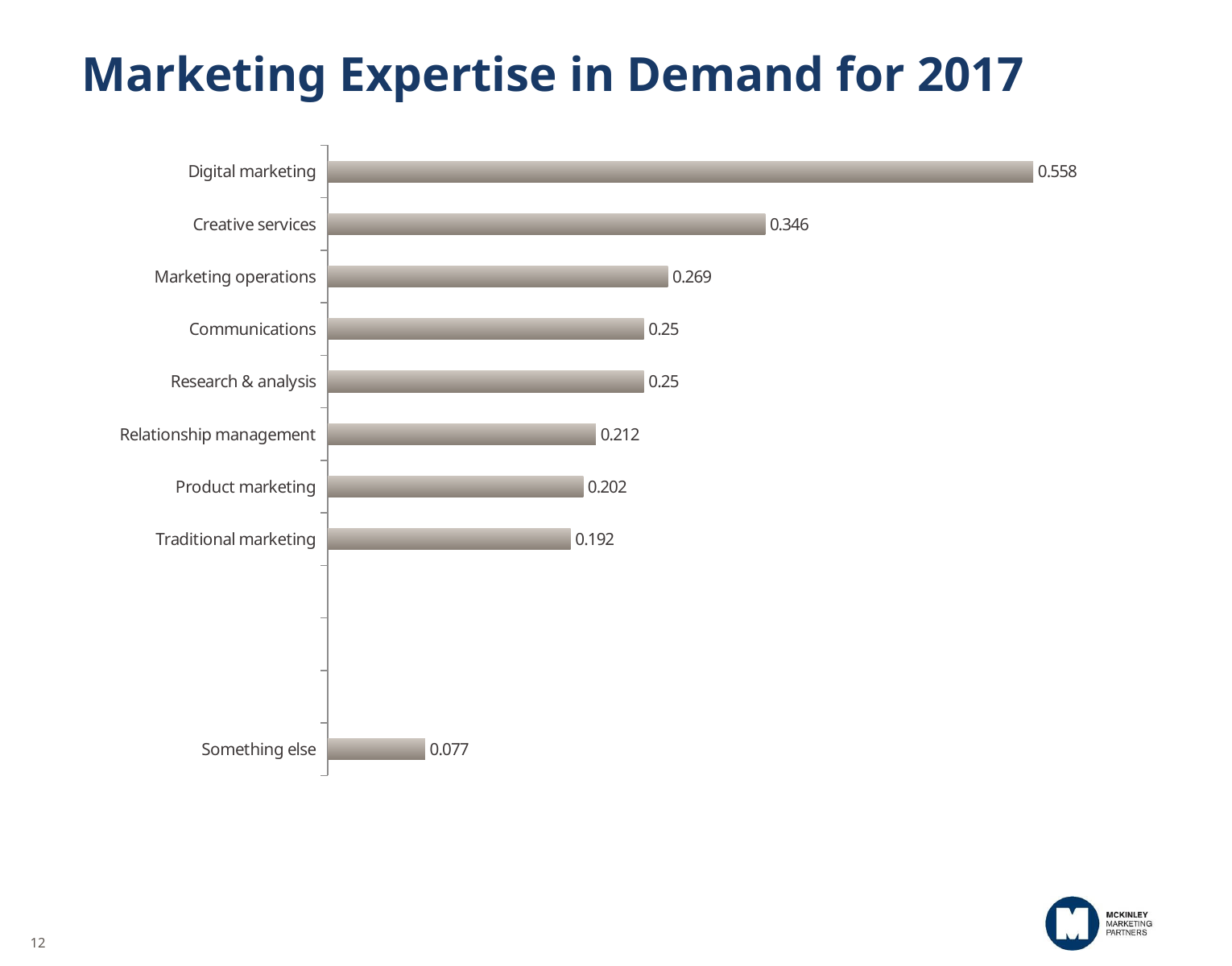
Which is larger, the value for Product marketing or the value for Traditional marketing? Product marketing How many bars are plotted in the chart? 9 What is the value for Something else? 0.077 What is the difference between the values for Digital marketing and Creative services? 0.212 Which category has the highest value? Digital marketing What is the title of the slide containing the chart? Marketing Expertise in Demand for 2017 What is the value for Relationship management? 0.212 What kind of chart is shown on the slide? Bar chart What is the value for Creative services? 0.346 What is the value for Digital marketing? 0.558 What is the difference between the values for Marketing operations and Traditional marketing? 0.077 Which category has the lowest value? Something else